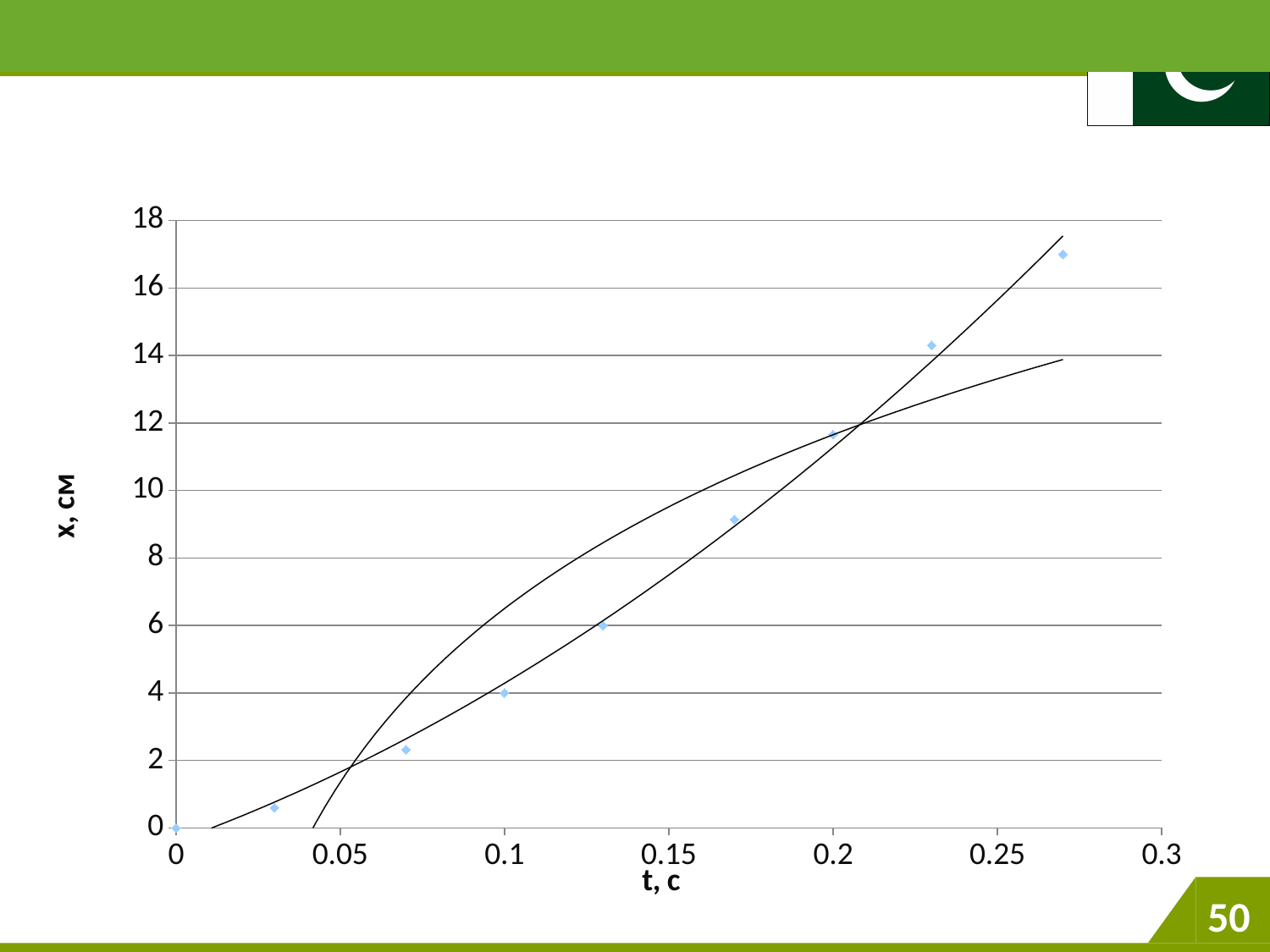
Is the value of x at t = 0.27 greater or less than 16? greater Is the value of x at t = 0.2 greater or less than 10? greater Is the value of x at t = 0.17 greater or less than 10? less Which is larger, the value of x at t = 0.13 or at t = 0.17? t = 0.17 What is the label of the vertical axis? x, см What is the label of the horizontal axis? t, c What kind of chart is shown on the slide? scatter chart Which plotted point has the highest value of x: the one at t = 0.23 or the one at t = 0.27? t = 0.27 Do the plotted values of x rise or fall as t increases along the x axis? rise